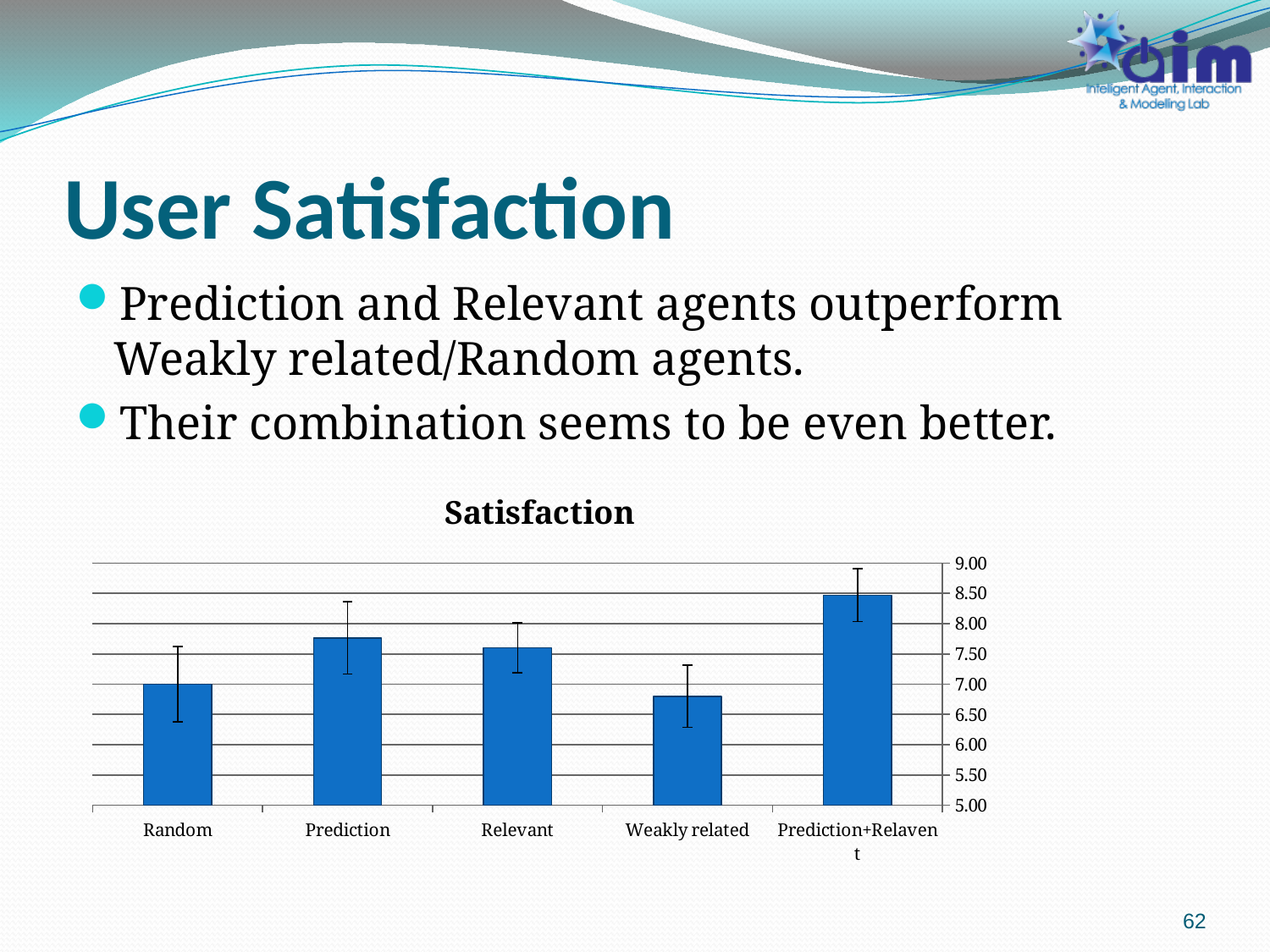
Is the value for Prediction+Relavent greater or less than 8.00? greater Which has a higher satisfaction value, Random or Prediction+Relavent? Prediction+Relavent Is the value for Weakly related greater or less than 7.00? less What is the title of the chart? Satisfaction What kind of chart is shown on the slide? Bar chart Is the value for Prediction greater or less than 7.50? greater How many categories are shown on the x axis of the chart? 5 Which category has the lowest satisfaction value? Weakly related Which has a higher satisfaction value, Prediction or Weakly related? Prediction Which category has the highest satisfaction value? Prediction+Relavent What is the lowest value shown on the vertical axis of the chart? 5.00